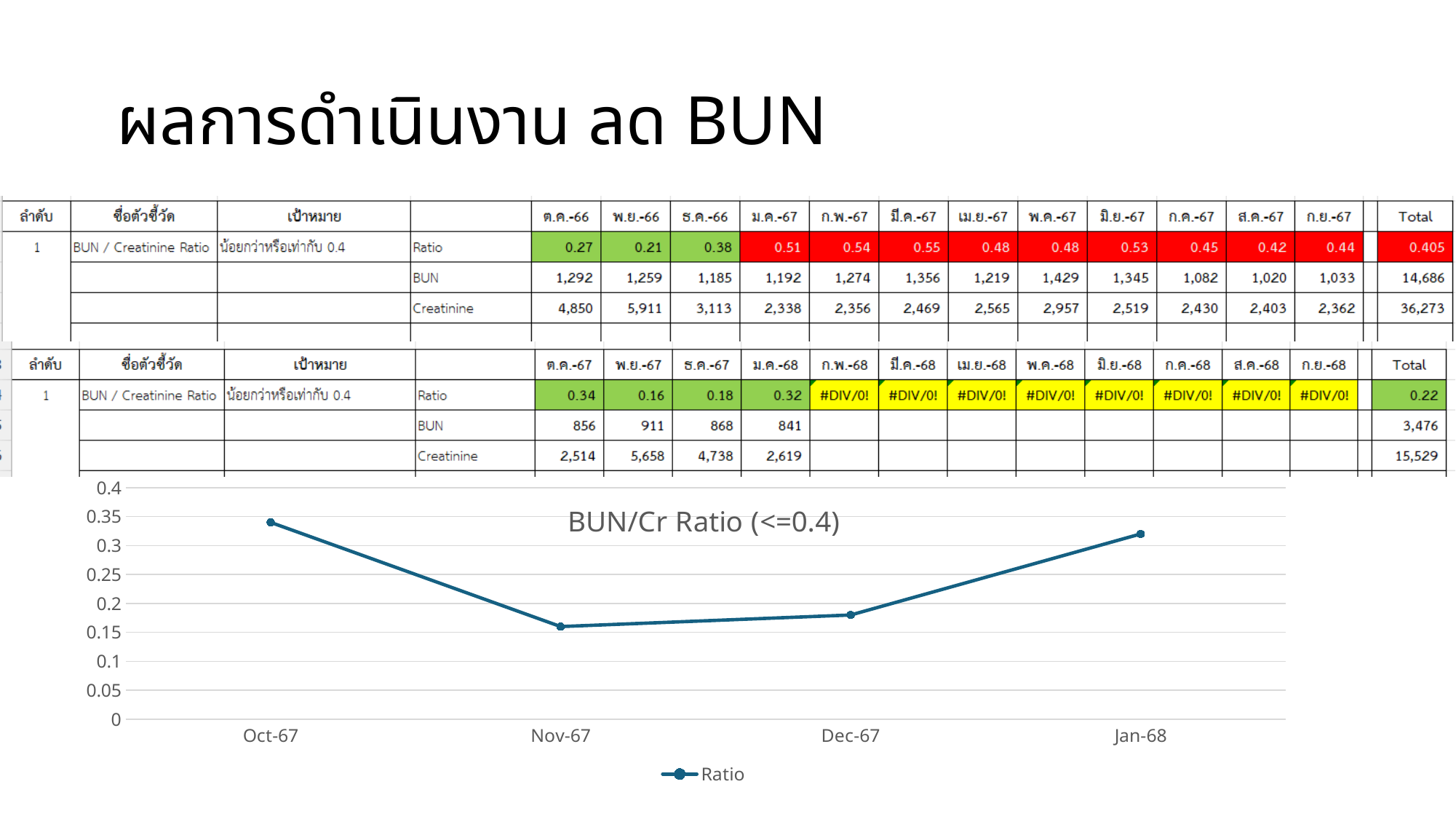
Is the Ratio value for Dec-67 greater or less than 0.2? less How many data points are plotted on the chart? 4 What is the name of the series shown in the chart legend? Ratio Is the Ratio value for Oct-67 greater or less than 0.3? greater Which has the larger Ratio value, Oct-67 or Nov-67? Oct-67 Does the Ratio rise or fall from Oct-67 to Nov-67? fall Is the Ratio value for Nov-67 greater or less than 0.2? less How many series does the chart legend list? 1 Which has the larger Ratio value, Dec-67 or Jan-68? Jan-68 What kind of chart is shown at the bottom of the slide? line chart What is the title of the chart? BUN/Cr Ratio (<=0.4)